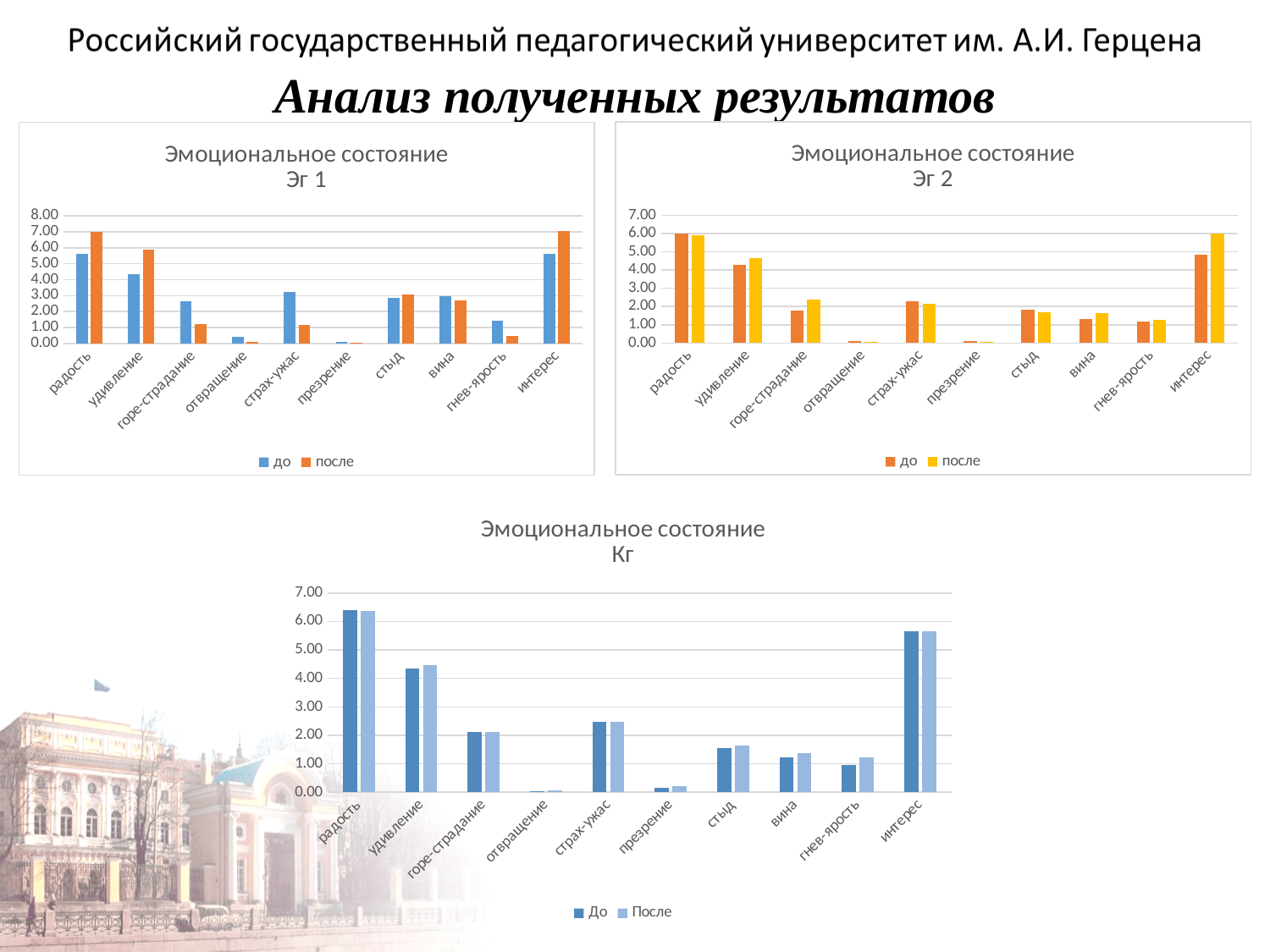
In the "Эмоциональное состояние Кг" chart, is the "До" value for удивление greater or less than 4.00? greater In the "Эмоциональное состояние Эг 2" chart, is the "после" value for интерес greater or less than 5.00? greater In the "Эмоциональное состояние Кг" chart, which category has the highest "До" value? радость In the "Эмоциональное состояние Эг 1" chart, which is larger for горе-страдание: "до" or "после"? до In the "Эмоциональное состояние Эг 1" chart, which category has the lowest "до" value? презрение How many series does the legend of the "Эмоциональное состояние Эг 2" chart list? 2 What kind of chart is the "Эмоциональное состояние Эг 1" chart? bar chart How many categories are shown on the x axis of the "Эмоциональное состояние Эг 1" chart? 10 In the "Эмоциональное состояние Эг 1" chart, is the "до" value for страх-ужас greater or less than 2.00? greater What are the two legend entries of the "Эмоциональное состояние Кг" chart? До, После In the "Эмоциональное состояние Эг 2" chart, which category has the highest "до" value? радость